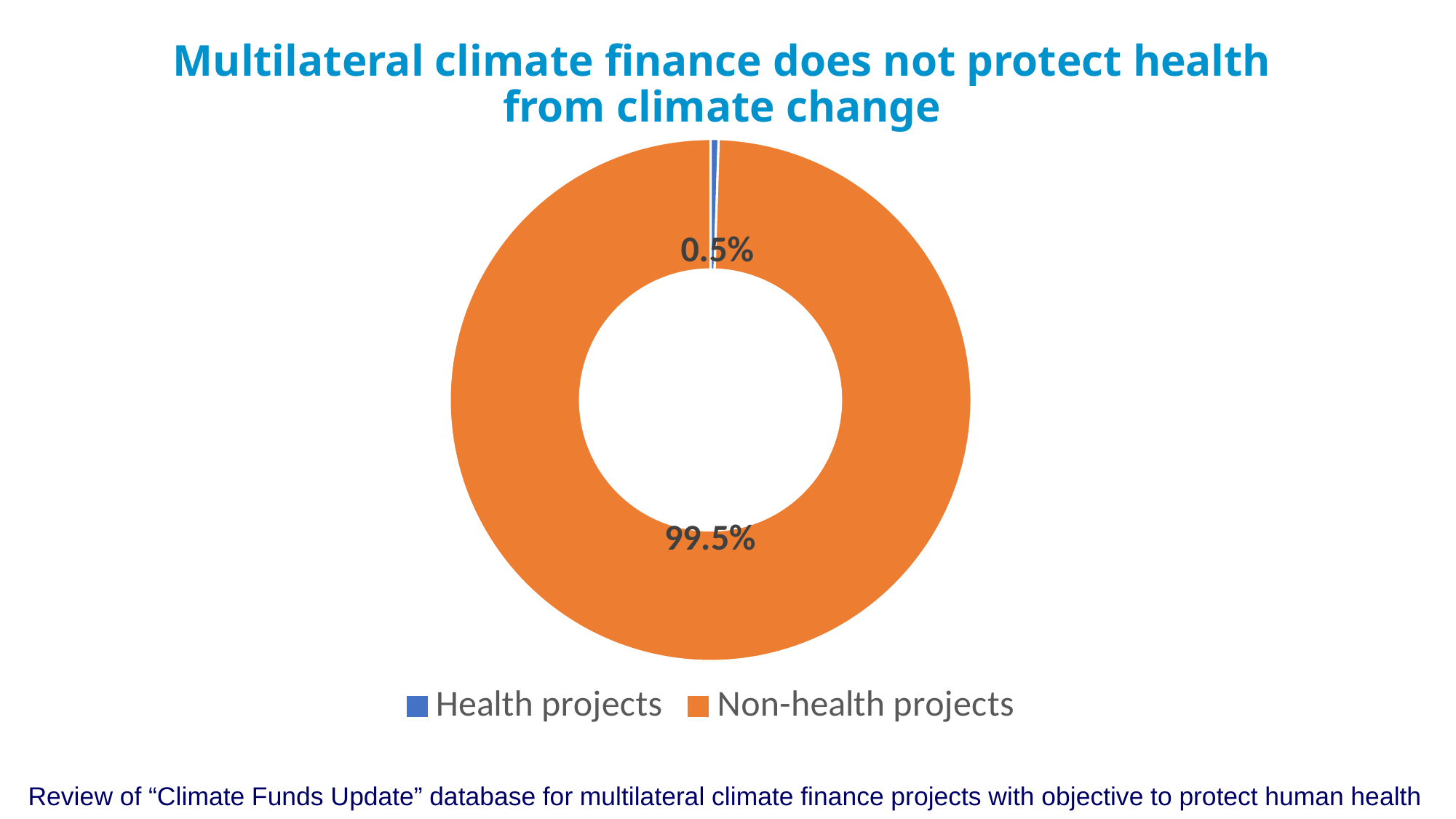
What colour represents Non-health projects in the chart? Orange What share of the chart is labelled for Health projects? 0.5% What share of the chart is labelled for Non-health projects? 99.5% What is the combined share of Health projects and Non-health projects? 100% How many entries does the legend list? 2 How many categories does the chart show? 2 What is the difference in percentage points between the Non-health projects share and the Health projects share? 99 percentage points Which is larger, the share for Health projects or the share for Non-health projects? Non-health projects Which category has the largest share of the chart? Non-health projects What kind of chart is shown on the slide? Doughnut (pie) chart Which category has the smallest share of the chart? Health projects What is the title of the chart? Multilateral climate finance does not protect health from climate change